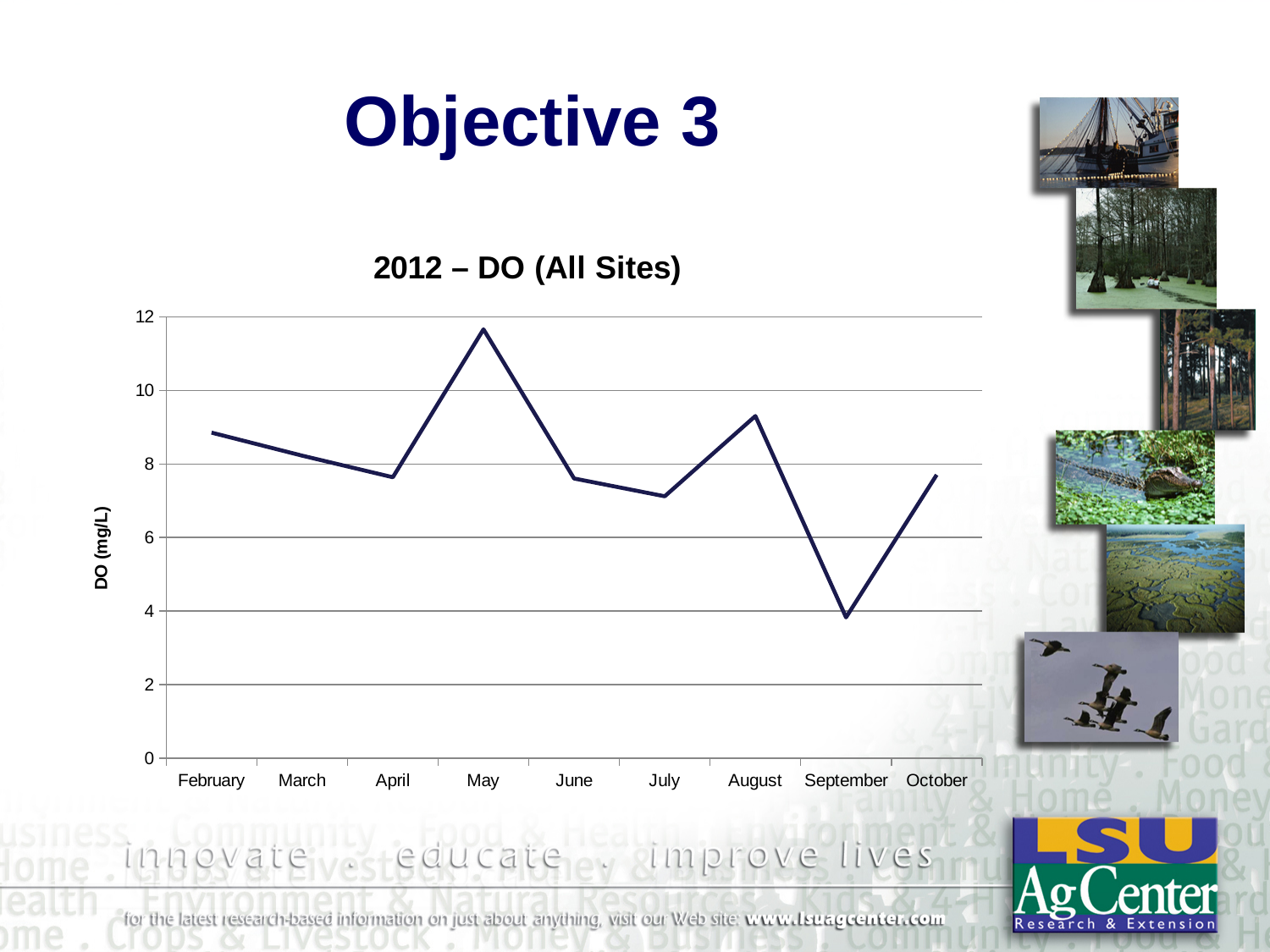
What kind of chart is shown on the slide? line chart What is the label on the vertical axis of the chart? DO (mg/L) Which month has a higher DO value, February or April? February How many months are plotted along the x axis? 9 Does the DO value rise or fall from August to September? fall Which month has the lowest DO value? September Which month has the highest DO value? May Is the DO value for August greater or less than 8? greater Is the DO value for July greater or less than 8? less What is the title of the chart? 2012 – DO (All Sites) Is the DO value for May greater or less than 10? greater